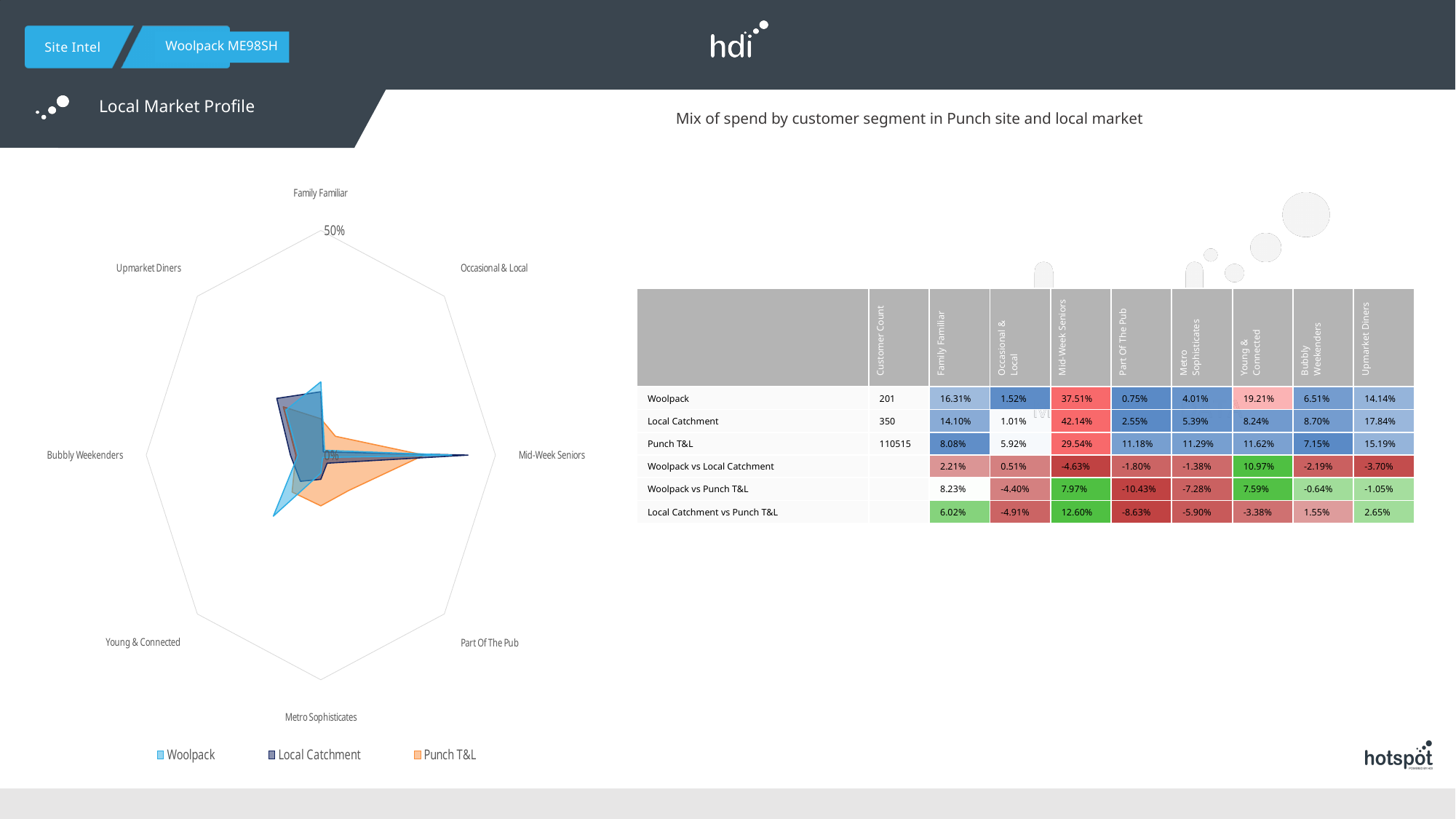
Which series in the radar chart is shown in orange? Punch T&L Which is larger for Young & Connected: the Woolpack value or the Local Catchment value? Woolpack Which customer segment has the highest value for Woolpack in the radar chart? Mid-Week Seniors According to the table, what is the Woolpack value for Mid-Week Seniors? 37.51% What is the outermost percentage tick shown on the radar chart? 50% How many series does the radar chart's legend list? 3 According to the table, what is the difference between Woolpack and Local Catchment for Family Familiar? 2.21% According to the table, what is the Local Catchment value for Upmarket Diners? 17.84% According to the table, what is the Punch T&L value for Part Of The Pub? 11.18% Is the Mid-Week Seniors value for Punch T&L greater or less than 50%? less What kind of chart is shown on the left of the slide? Radar chart How many customer segments (axes) does the radar chart have? 8